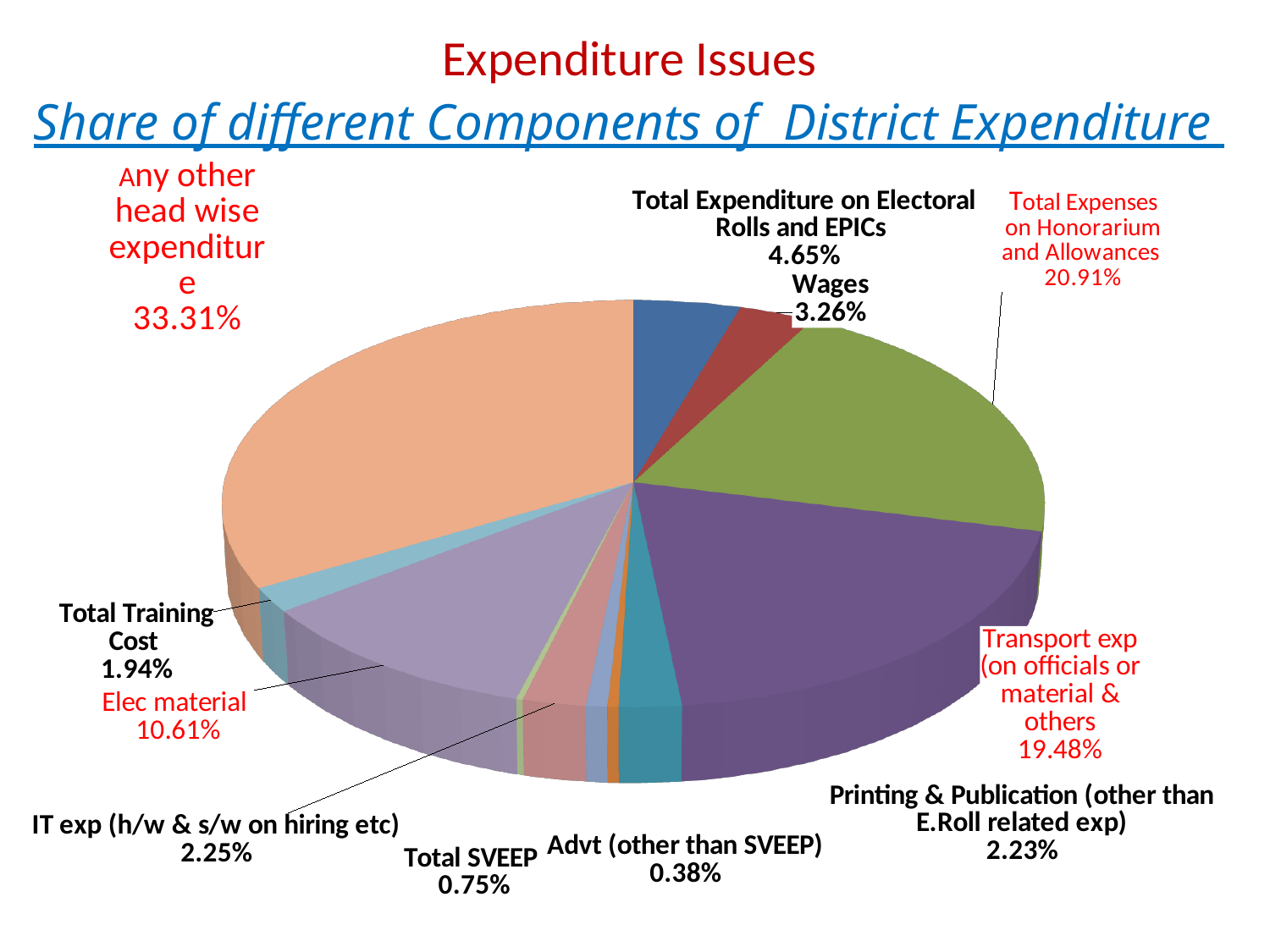
What is the title of the chart? Share of different Components of District Expenditure What share of district expenditure is Wages? 3.26% What share of district expenditure is Elec material? 10.61% Which component has the largest share of district expenditure? Any other head wise expenditure What share of district expenditure is Total Expenses on Honorarium and Allowances? 20.91% What kind of chart is shown on the slide? Pie chart What is the difference in share between Total Expenses on Honorarium and Allowances and Transport exp? 1.43% What share of district expenditure is Any other head wise expenditure? 33.31% Which has a larger share: Total Expenditure on Electoral Rolls and EPICs or Wages? Total Expenditure on Electoral Rolls and EPICs What share of district expenditure is Total SVEEP? 0.75% How many expenditure components are shown in the pie chart? 12